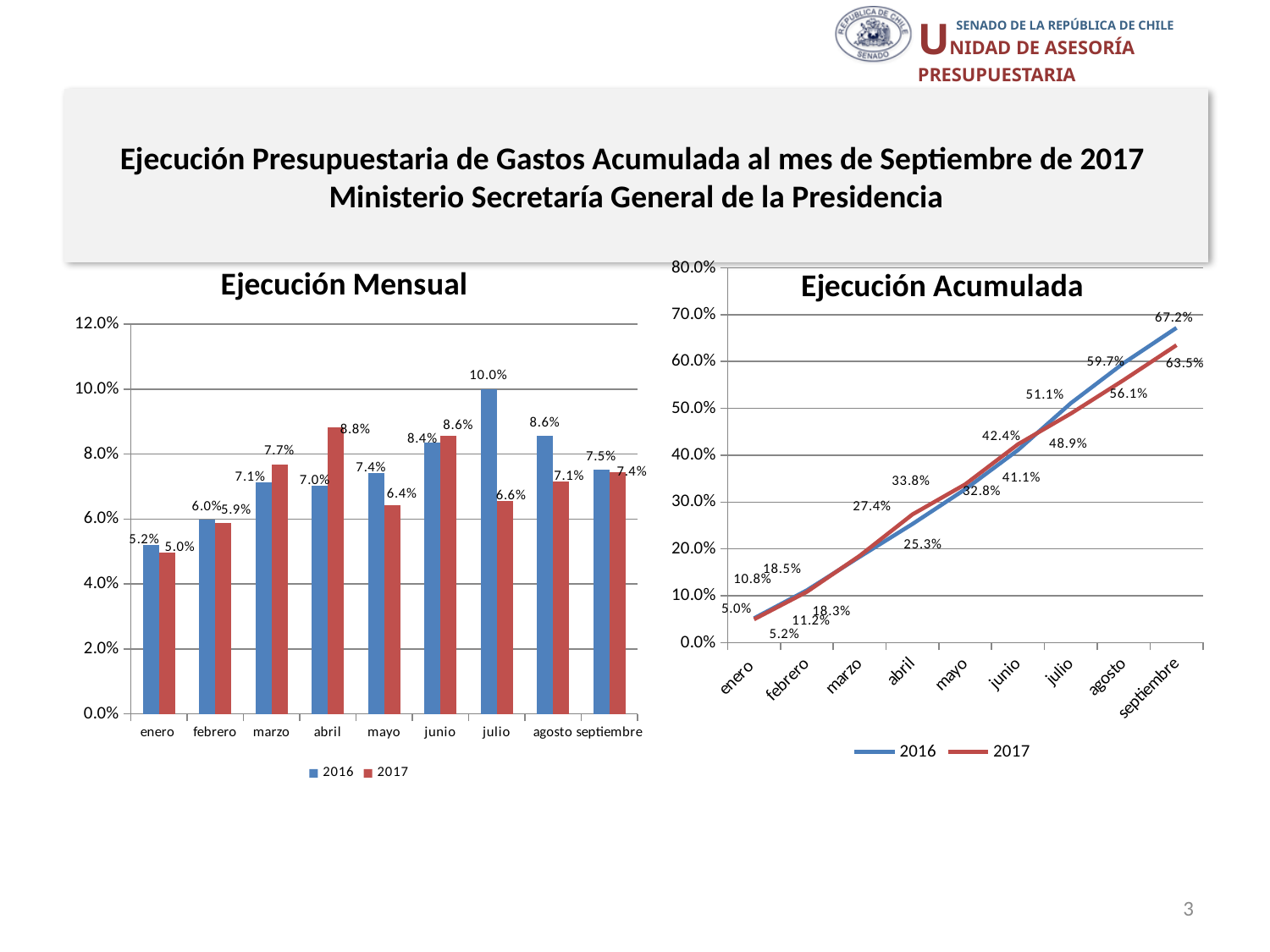
In the Ejecución Mensual chart, which month has the lowest value for 2017? enero In the Ejecución Mensual chart, what is the value for 2017 in abril? 8.8% In the Ejecución Mensual chart, which is larger in mayo, the 2016 value or the 2017 value? 2016 In the Ejecución Acumulada chart, which series is higher in septiembre, 2016 or 2017? 2016 In the Ejecución Mensual chart, which month has the highest value for 2016? julio What kind of chart is the Ejecución Mensual chart? bar chart In the Ejecución Mensual chart, what is the value for 2016 in julio? 10.0% In the Ejecución Acumulada chart, what is the value for 2016 in septiembre? 67.2% In the Ejecución Mensual chart, what is the difference between the 2016 and 2017 values in julio? 3.4% How many series does the legend of the Ejecución Acumulada chart list? 2 How many months are shown on the x axis of the Ejecución Mensual chart? 9 What kind of chart is the Ejecución Acumulada chart? line chart